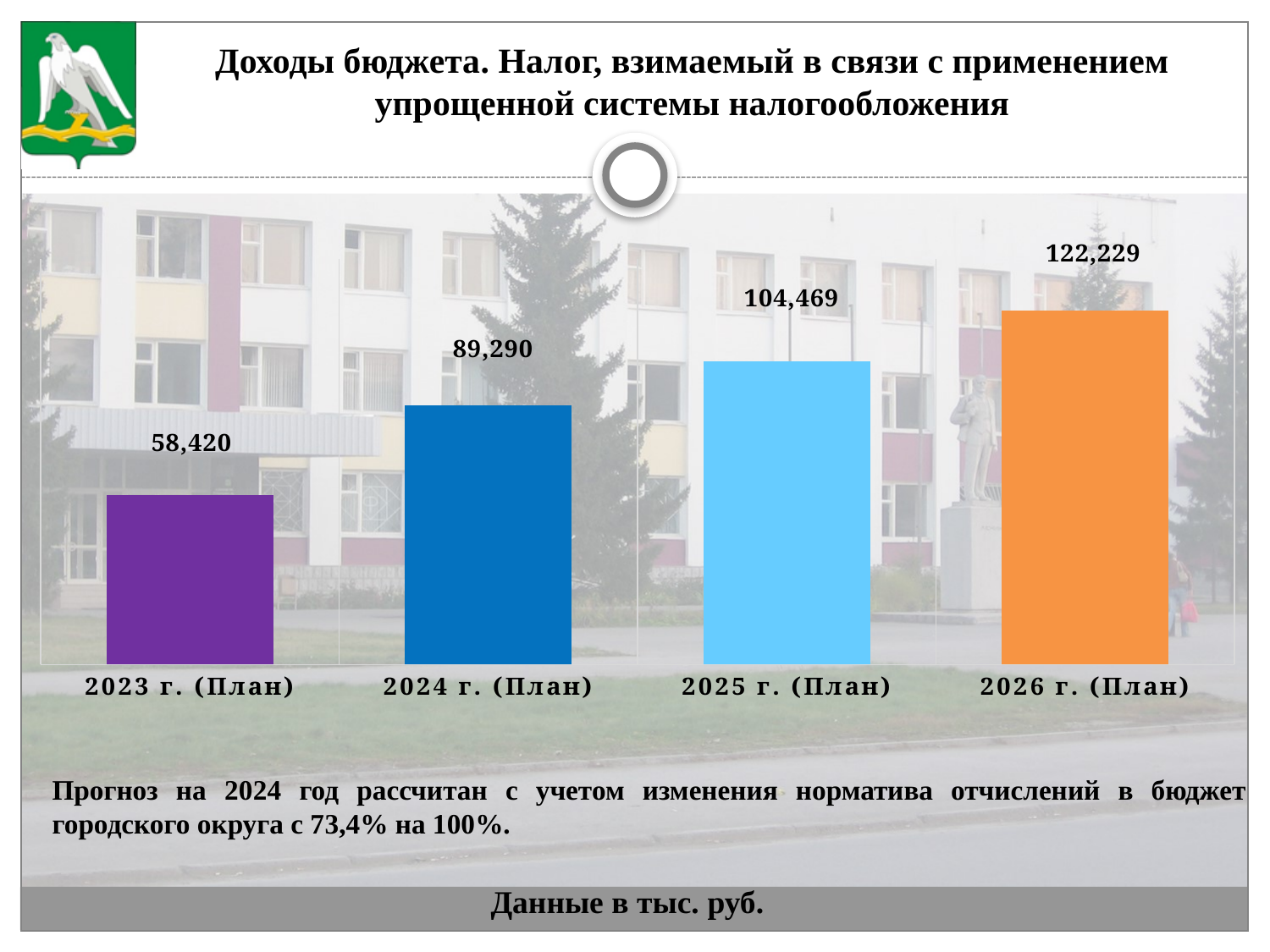
Do the values rise or fall from 2023 г. (План) to 2026 г. (План)? Rise What is the value for 2025 г. (План)? 104,469 Which is larger, the value for 2025 г. (План) or the value for 2024 г. (План)? 2025 г. (План) How many categories are shown in the chart? 4 What kind of chart is shown on the slide? Bar chart Which category has the lowest value? 2023 г. (План) What is the difference between the values for 2026 г. (План) and 2025 г. (План)? 17,760 Which category has the highest value? 2026 г. (План) What is the difference between the values for 2024 г. (План) and 2023 г. (План)? 30,870 What is the value for 2026 г. (План)? 122,229 What is the value for 2023 г. (План)? 58,420 What is the value for 2024 г. (План)? 89,290